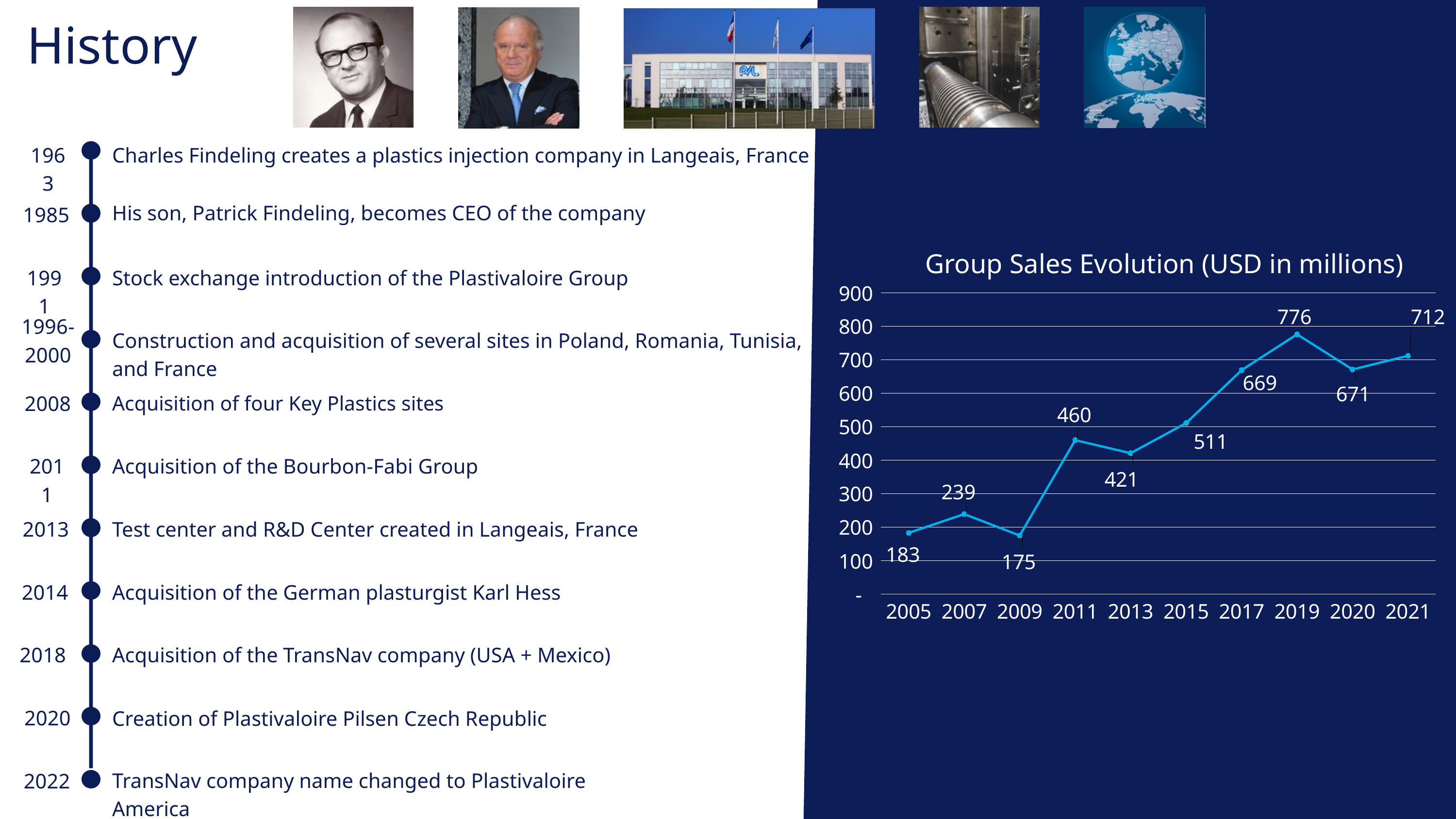
Do the Group Sales values rise or fall between 2009 and 2019? rise How many years are plotted on the Group Sales Evolution chart? 10 Which is larger, the Group Sales value for 2011 or for 2013? 2011 What is the title of the chart on the slide? Group Sales Evolution (USD in millions) What is the difference between the Group Sales values for 2021 and 2020? 41 What kind of chart is the Group Sales Evolution chart? line chart What is the Group Sales value for 2019? 776 What is the Group Sales value for 2013? 421 Which year has the lowest Group Sales value? 2009 What is the Group Sales value for 2005? 183 Is the Group Sales value for 2017 greater or less than 600? greater Which year has the highest Group Sales value? 2019